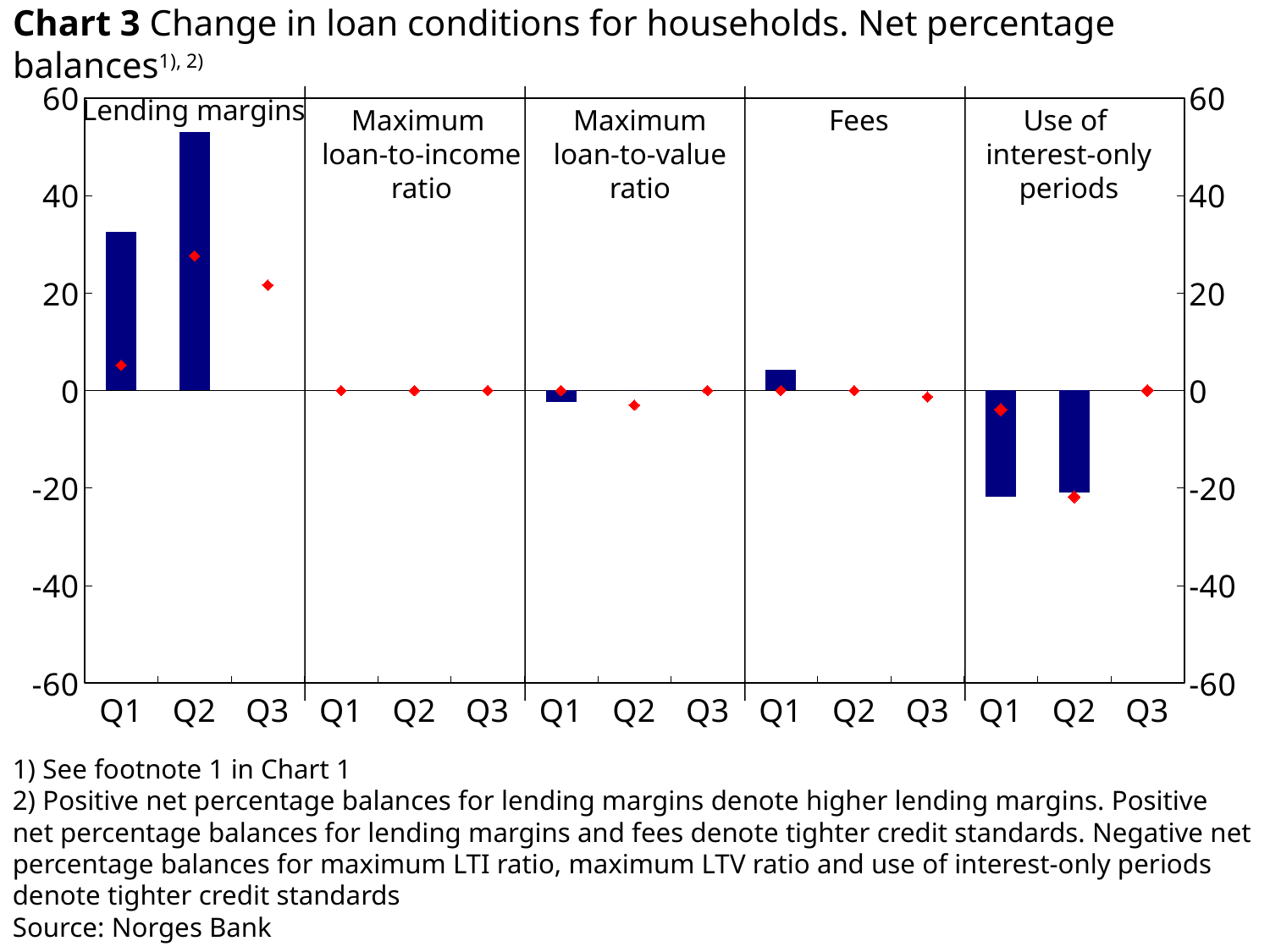
What kind of chart is shown on the slide? combination bar and marker chart (bars with diamond point markers) How many loan condition panels are shown on the chart? 5 Which of the two Lending margins bars is larger, Q1 or Q2? Q2 Which is larger, the Q1 bar for Fees or the Q1 bar for Lending margins? Q1 bar for Lending margins What is the source given for the chart? Norges Bank Is the Q2 bar for Lending margins greater or less than 40? greater Is the Q1 bar for Use of interest-only periods greater or less than -20? less Which quarter has the tallest bar in the Lending margins panel? Q2 Which panel shows no bars at all, only markers at zero? Maximum loan-to-income ratio Which panel contains the bar with the highest value on the chart? Lending margins Is the Q1 bar for Fees greater or less than 20? less